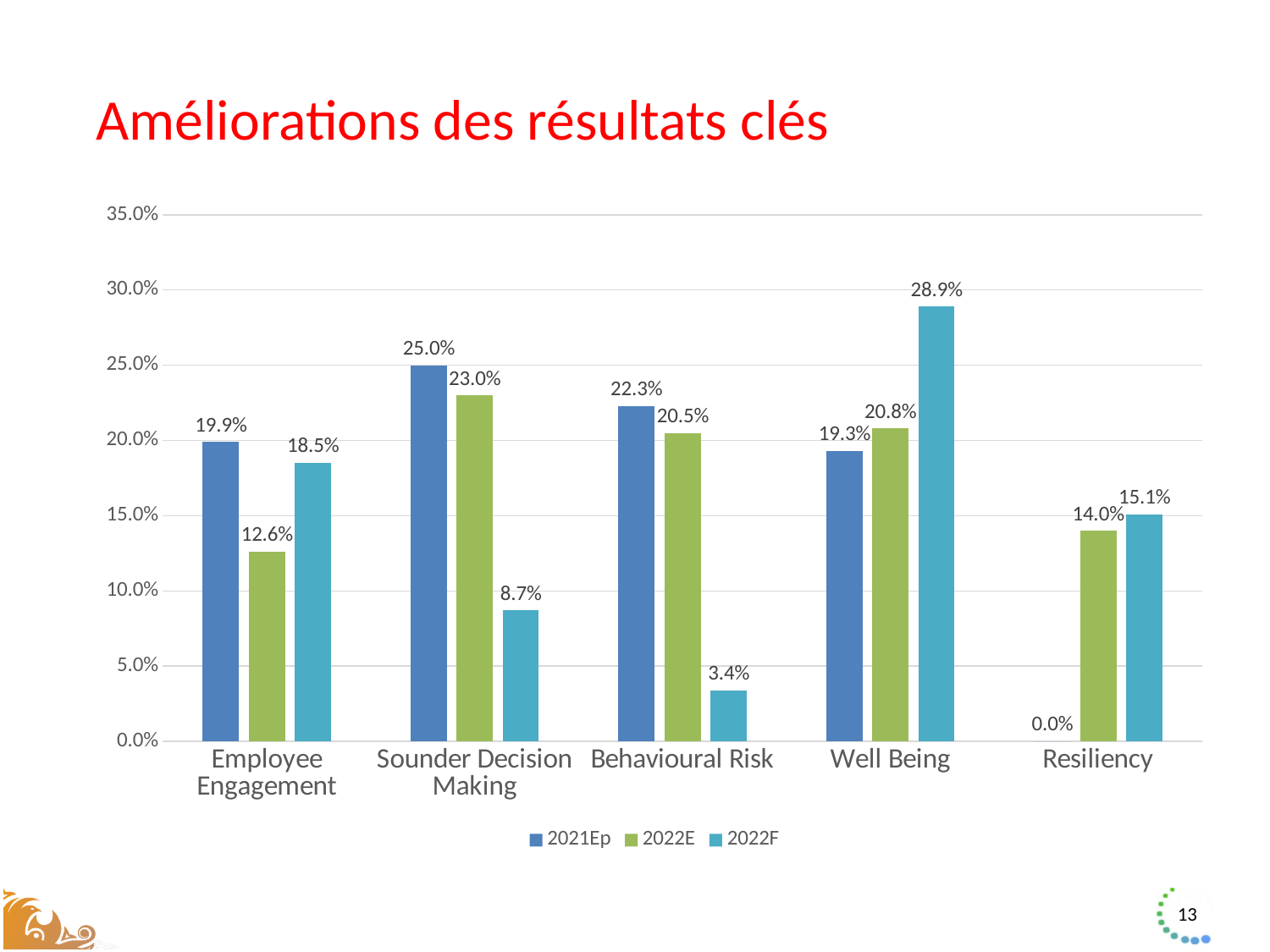
What kind of chart is shown on the slide? Bar chart What is the 2021Ep value for Sounder Decision Making? 25.0% How many categories are shown on the x axis? 5 What is the title of the slide? Améliorations des résultats clés What is the 2022F value for Resiliency? 15.1% What is the 2022F value for Well Being? 28.9% Which category has the lowest 2021Ep value? Resiliency How many series does the legend list? 3 What is the difference between the 2021Ep and 2022F values for Behavioural Risk? 18.9% What is the 2022E value for Employee Engagement? 12.6% Which is larger for Sounder Decision Making: the 2022E value or the 2022F value? 2022E Which category has the highest 2022F value? Well Being